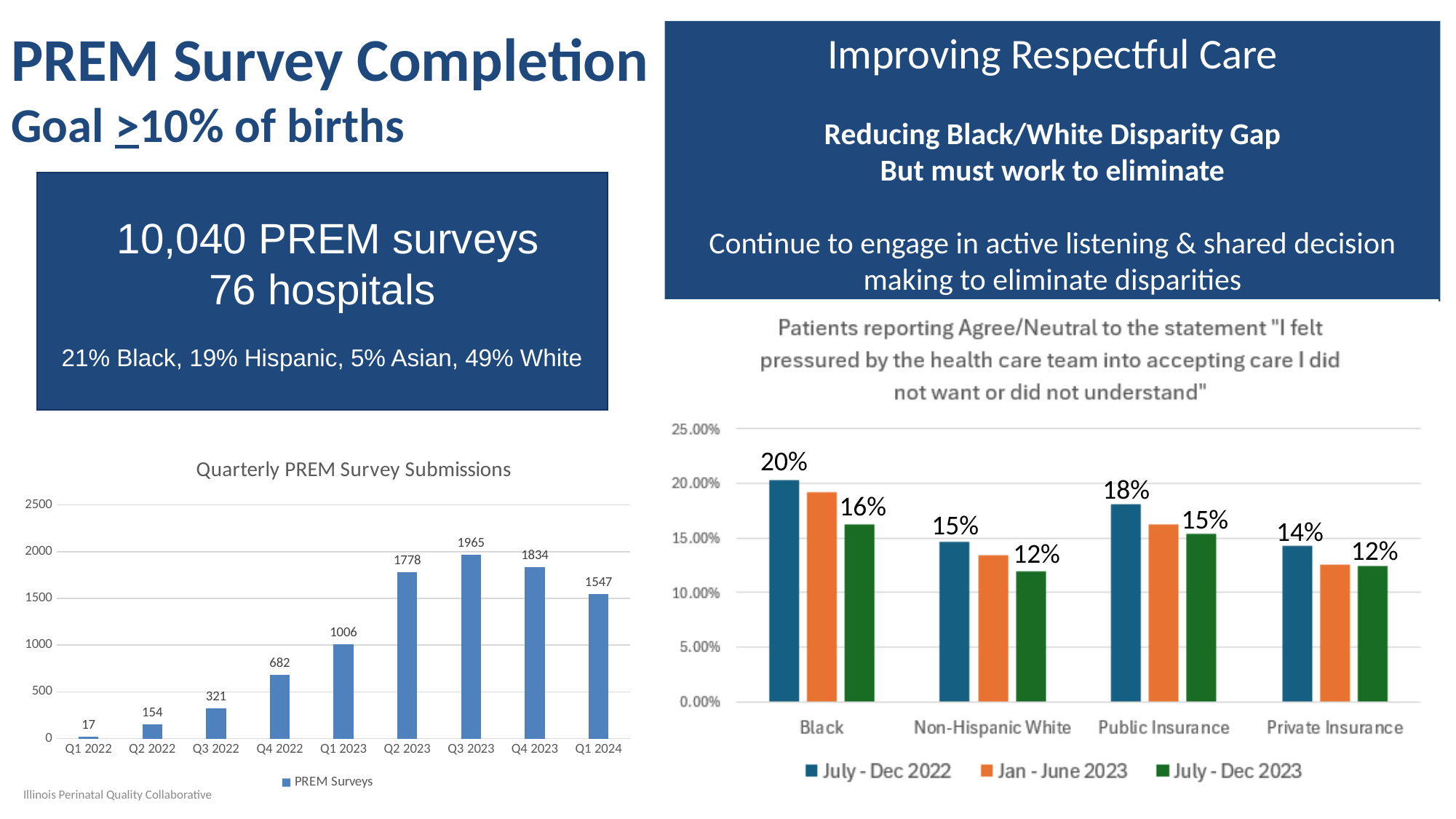
In the Quarterly PREM Survey Submissions chart, what is the difference in submissions between Q2 2023 and Q1 2023? 772 In the Quarterly PREM Survey Submissions chart, how many PREM surveys were submitted in Q3 2023? 1965 In the Quarterly PREM Survey Submissions chart, which is larger: submissions in Q4 2023 or Q1 2024? Q4 2023 In the Quarterly PREM Survey Submissions chart, how many quarters are shown on the x axis? 9 In the chart on the right about patients feeling pressured by the health care team, what is the value for Black patients in July - Dec 2022? 20% In the chart on the right about patients feeling pressured by the health care team, how many series does the legend list? 3 In the chart on the right about patients feeling pressured by the health care team, what is the value for Public Insurance in July - Dec 2023? 15% In the chart on the right about patients feeling pressured by the health care team, what is the difference between the July - Dec 2022 and July - Dec 2023 values for Black patients? 4% In the Quarterly PREM Survey Submissions chart, which quarter has the highest number of submissions? Q3 2023 In the chart on the right about patients feeling pressured by the health care team, is the Jan - June 2023 value for Black patients greater or less than 15.00%? greater What kind of chart is the Quarterly PREM Survey Submissions chart? bar chart In the Quarterly PREM Survey Submissions chart, how many PREM surveys were submitted in Q1 2022? 17